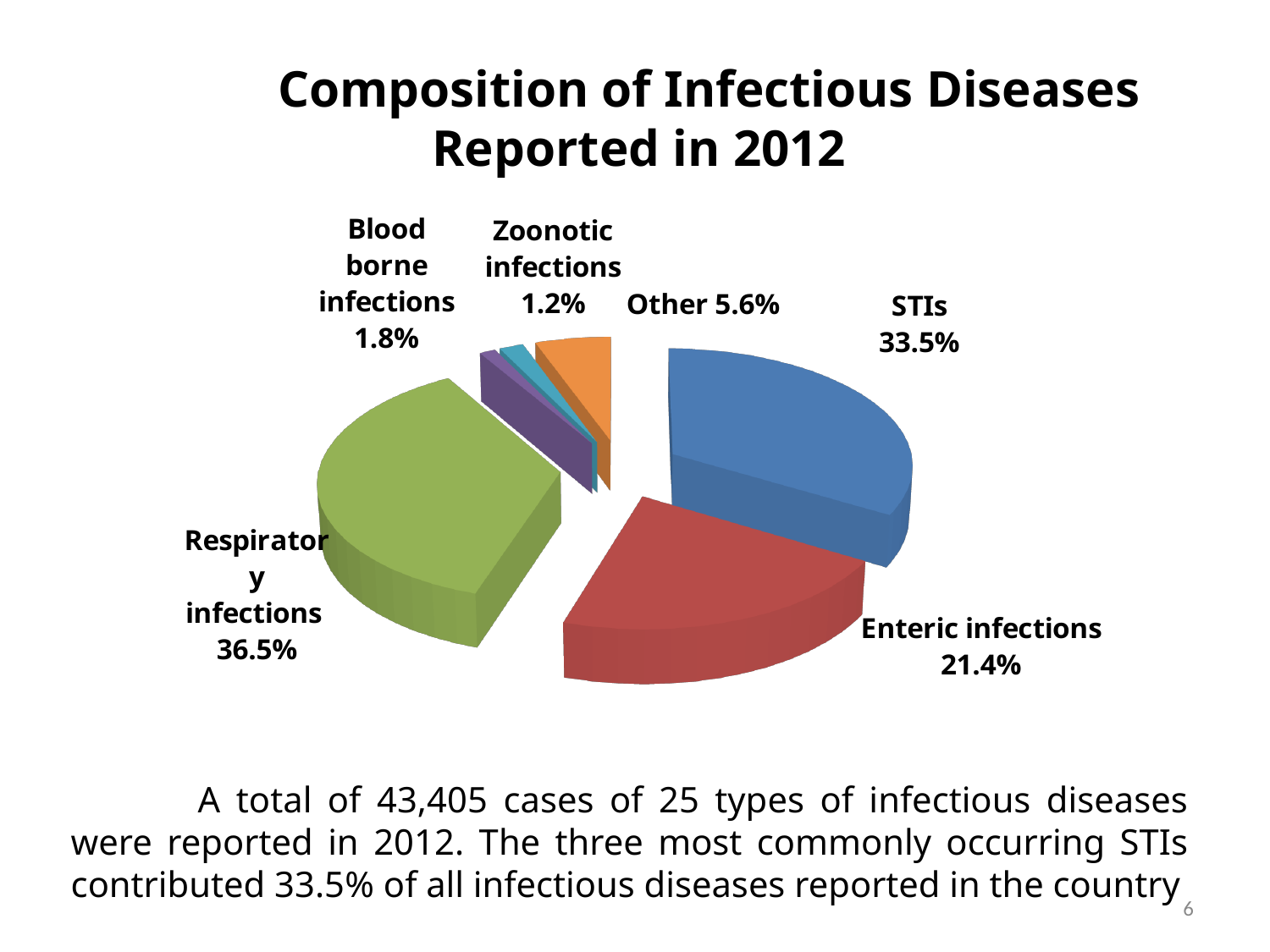
What percentage of the pie is Enteric infections? 21.4% What share of the pie is the Other category? 5.6% How many percentage points larger is the STIs share than the Enteric infections share? 12.1 Which is larger, the share for Other or the share for Blood borne infections? Other Which category has the largest share of the pie? Respiratory infections What type of chart is shown on the slide? Pie chart What is the value shown for Blood borne infections? 1.8% What share do Respiratory infections account for? 36.5% How many categories are shown in the pie chart? 6 What percentage is labelled for Zoonotic infections? 1.2% What share of infectious diseases reported in 2012 were STIs? 33.5% Which category has the smallest share of the pie? Zoonotic infections